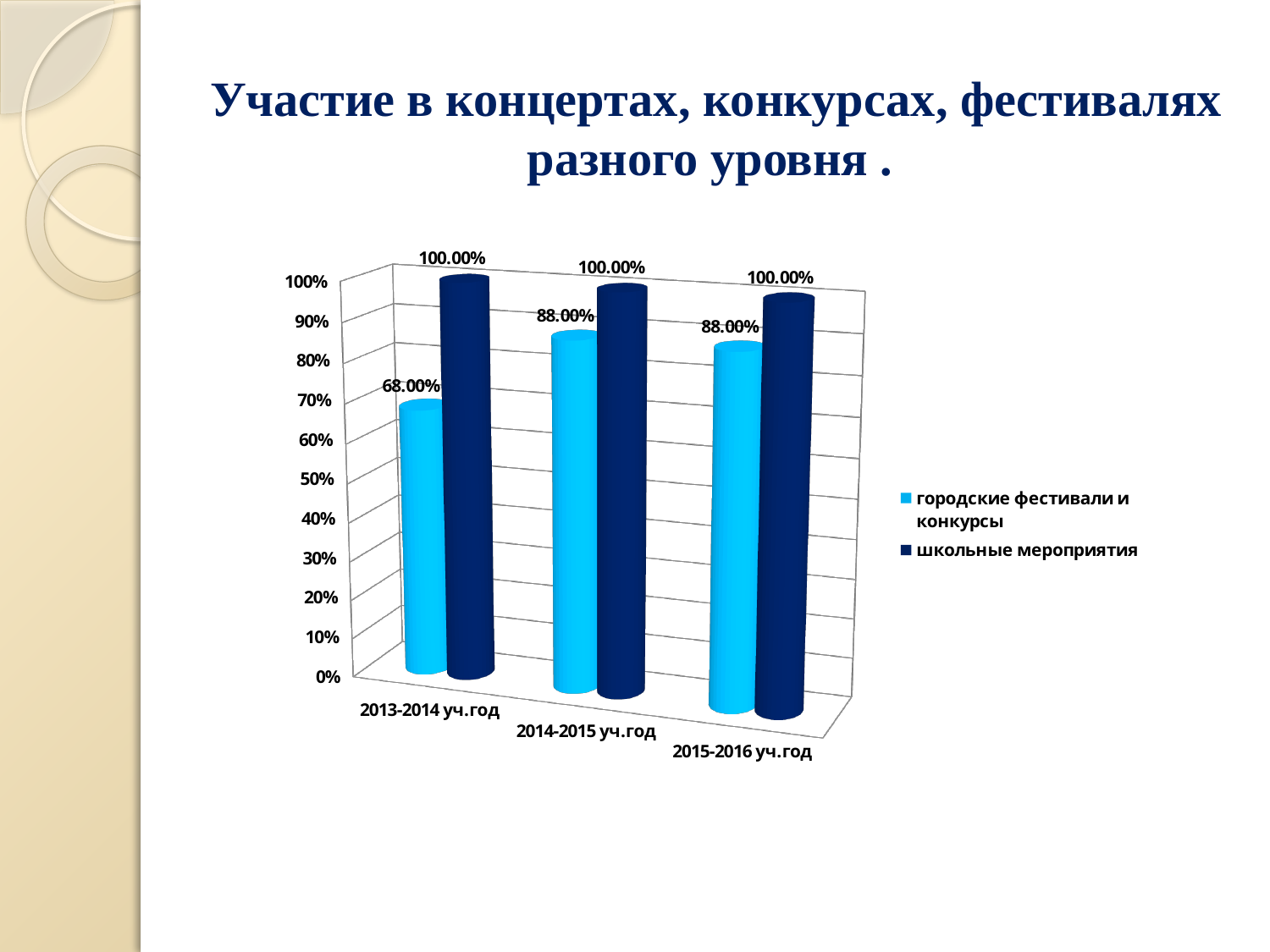
Which is larger in 2014-2015 уч.год: городские фестивали и конкурсы or школьные мероприятия? школьные мероприятия What is the value for школьные мероприятия in 2014-2015 уч.год? 100.00% How many series does the legend list? 2 What is the value for городские фестивали и конкурсы in 2013-2014 уч.год? 68.00% What kind of chart is shown on the slide? bar chart Is the value for городские фестивали и конкурсы in 2013-2014 уч.год greater or less than 70%? less Do the values for городские фестивали и конкурсы rise or fall from 2013-2014 уч.год to 2015-2016 уч.год? rise How many academic years are shown on the x axis? 3 What is the difference between the городские фестивали и конкурсы values for 2014-2015 уч.год and 2013-2014 уч.год? 20.00% Which year has the lowest value for городские фестивали и конкурсы? 2013-2014 уч.год What is the value for городские фестивали и конкурсы in 2015-2016 уч.год? 88.00% What is the difference between школьные мероприятия and городские фестивали и конкурсы in 2013-2014 уч.год? 32.00%